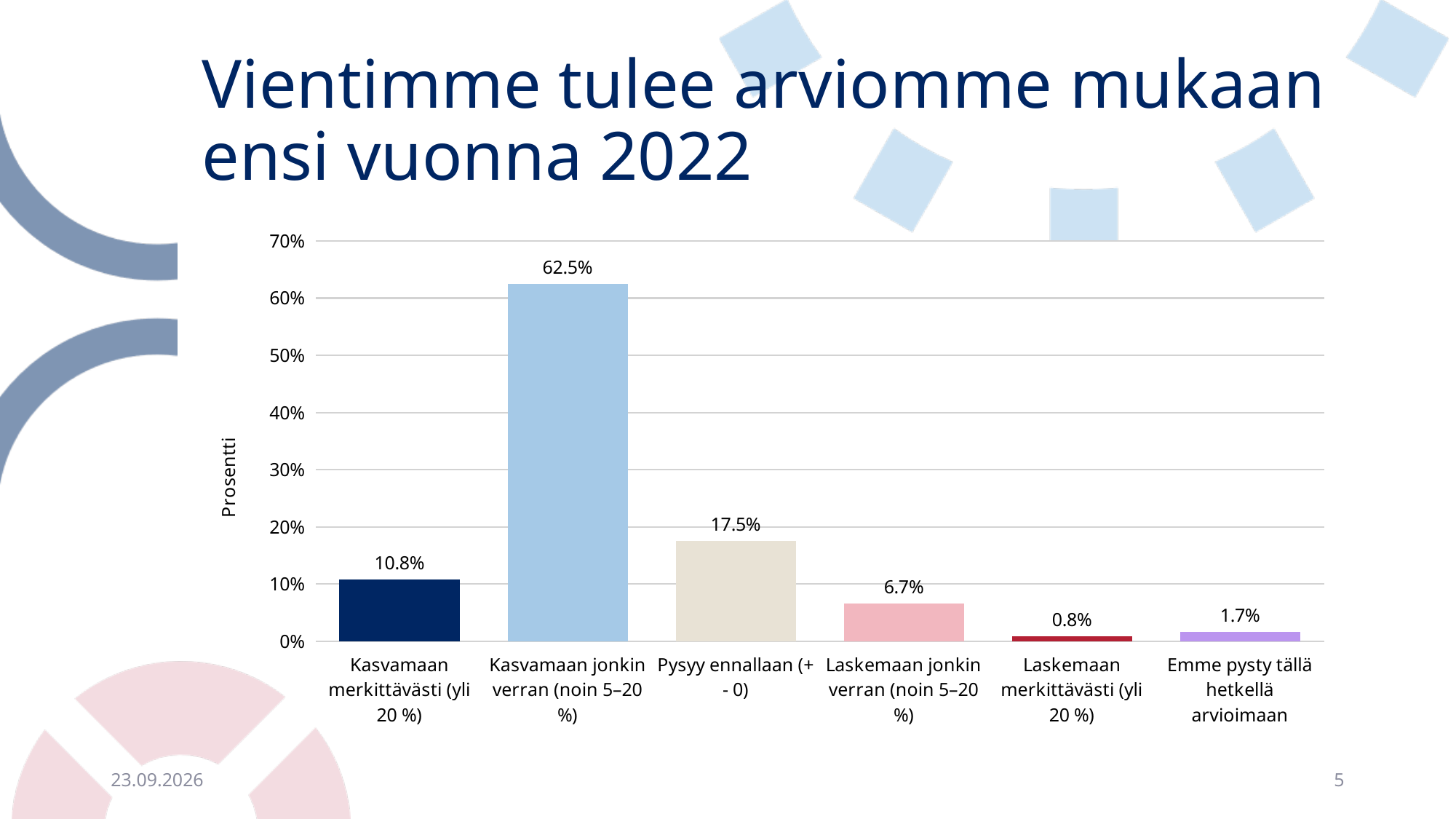
What is the value for 'Emme pysty tällä hetkellä arvioimaan'? 1.7% What is the value for 'Pysyy ennallaan (+ - 0)'? 17.5% What is the difference between 'Kasvamaan jonkin verran (noin 5–20 %)' and 'Pysyy ennallaan (+ - 0)'? 45 percentage points Which category has the lowest value? Laskemaan merkittävästi (yli 20 %) How many categories are shown in the chart? 6 What is the label of the vertical axis? Prosentti Which category has the highest value? Kasvamaan jonkin verran (noin 5–20 %) Which is larger: 'Kasvamaan merkittävästi (yli 20 %)' or 'Laskemaan jonkin verran (noin 5–20 %)'? Kasvamaan merkittävästi (yli 20 %) What percentage of respondents expect exports to grow somewhat (Kasvamaan jonkin verran (noin 5–20 %))? 62.5% What type of chart is shown on the slide? Bar chart What is the difference between 'Kasvamaan merkittävästi (yli 20 %)' and 'Laskemaan jonkin verran (noin 5–20 %)'? 4.1 percentage points Is the value for 'Kasvamaan jonkin verran (noin 5–20 %)' greater or less than 60%? greater